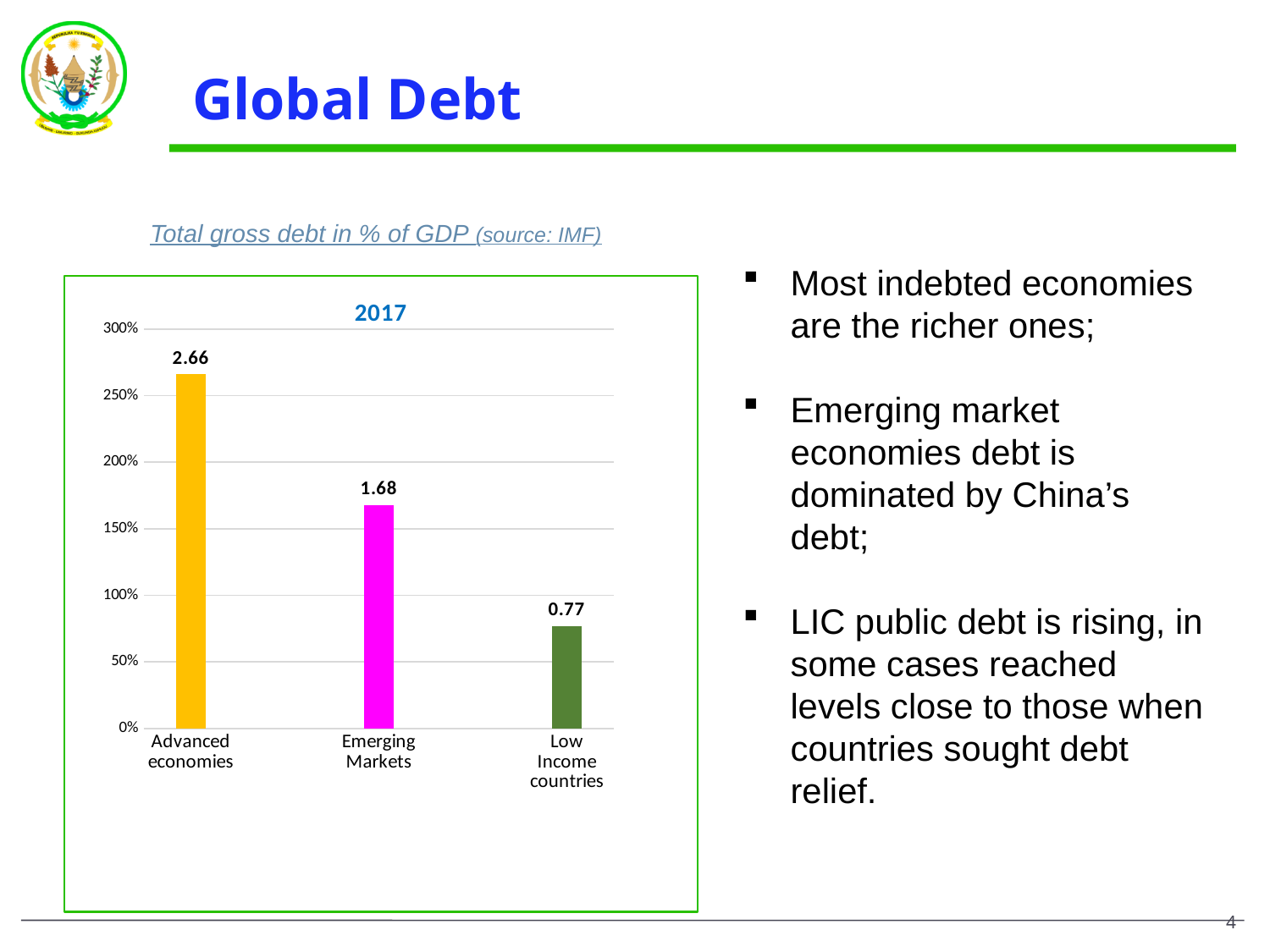
Is the bar for Low Income countries greater or less than 100%? less What is the value shown for Emerging Markets? 1.68 Which is larger, the value for Emerging Markets or the value for Low Income countries? Emerging Markets What is the title shown inside the chart? 2017 What is the value shown for Advanced economies? 2.66 What is the value shown for Low Income countries? 0.77 How many categories are shown on the chart? 3 What kind of chart is shown on the slide? bar chart What is the difference between the values for Emerging Markets and Low Income countries? 0.91 What is the difference between the values for Advanced economies and Emerging Markets? 0.98 Which category has the lowest value? Low Income countries Which category has the highest value? Advanced economies